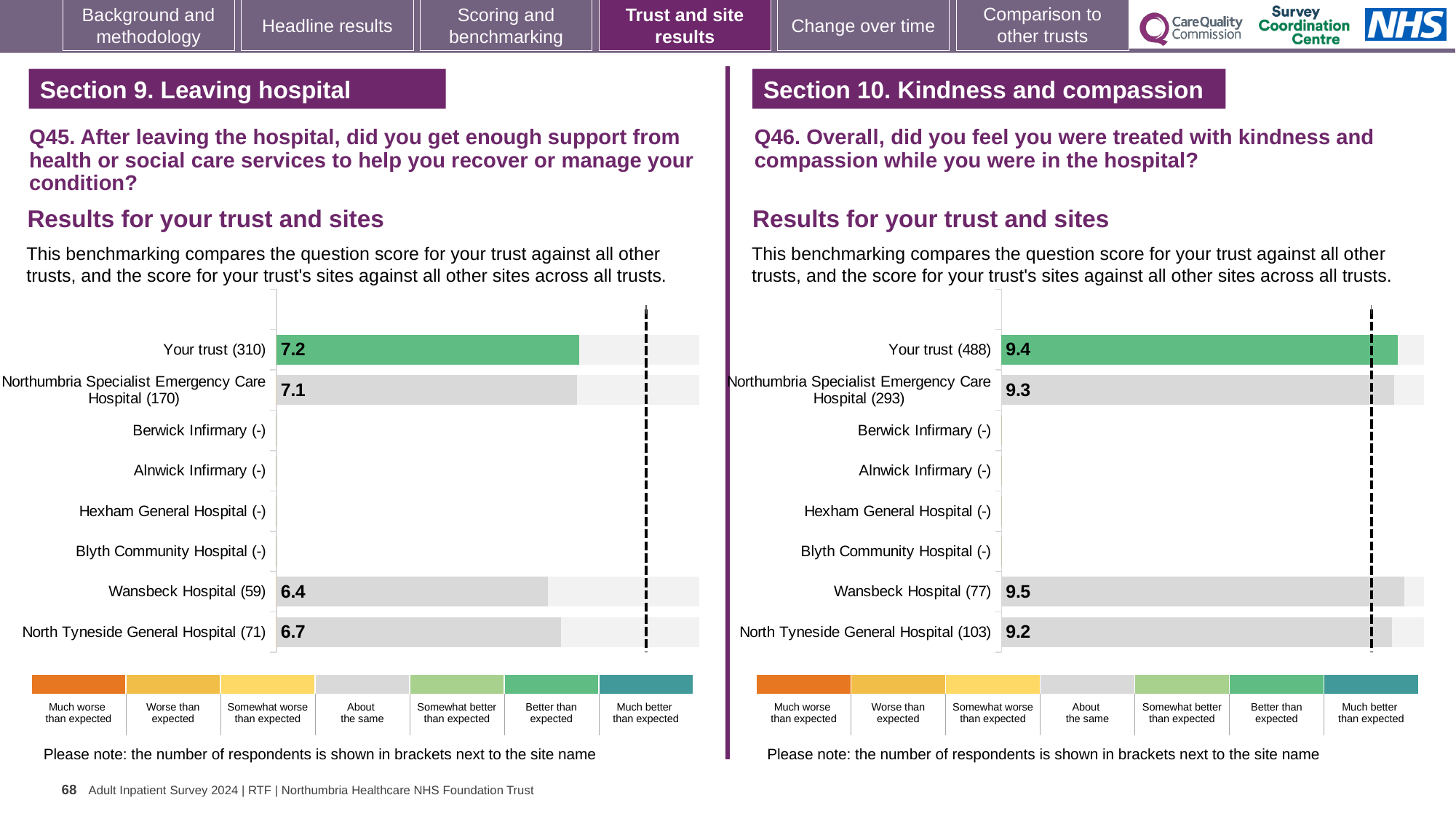
On the Q46 chart (right), which site with a plotted score has the highest value? Wansbeck Hospital How many respondents are shown in brackets for Your trust on the Q46 chart (right)? 488 On the Q45 chart (left), which is larger: the score for Northumbria Specialist Emergency Care Hospital or for North Tyneside General Hospital? Northumbria Specialist Emergency Care Hospital On the Q46 chart (right), what is the score for Your trust? 9.4 On the Q45 chart (left), what is the score for Wansbeck Hospital? 6.4 On the Q46 chart (right), what is the difference between the scores for Wansbeck Hospital and North Tyneside General Hospital? 0.3 On the Q46 chart (right), what is the score for North Tyneside General Hospital? 9.2 What kind of chart is used for the Q46 results (right)? Bar chart How many site or trust labels are listed on the Q45 chart (left)? 8 On the Q45 chart (left), what is the difference between the scores for Your trust and North Tyneside General Hospital? 0.5 On the Q45 chart (left), what is the score for Your trust? 7.2 On the Q45 chart (left), which site with a plotted score has the lowest value? Wansbeck Hospital